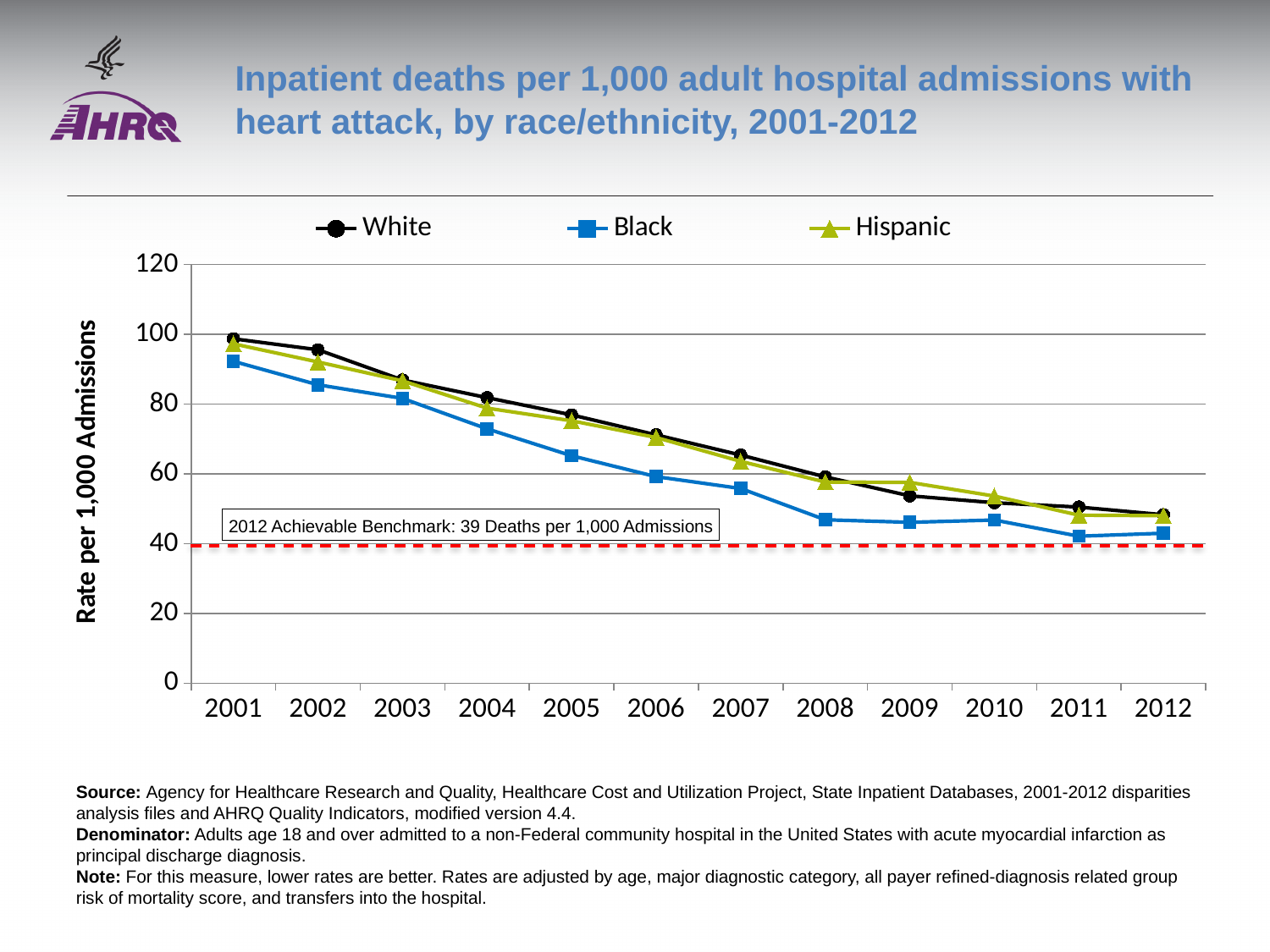
Is the value for White in 2001 greater or less than 80? greater Is the value for Black in 2008 greater or less than 60? less Is the value for Black in 2012 greater or less than 60? less In which year is the Black series at its highest? 2001 How many years are plotted along the x axis? 12 In 2008, which series has the higher value, Black or Hispanic? Hispanic What is the 2012 achievable benchmark shown on the chart? 39 Deaths per 1,000 Admissions Do the rates for the White series rise or fall from 2001 to 2012? Fall What kind of chart is shown on the slide? Line chart In 2001, which series has the higher value, White or Black? White How many series does the legend list? 3